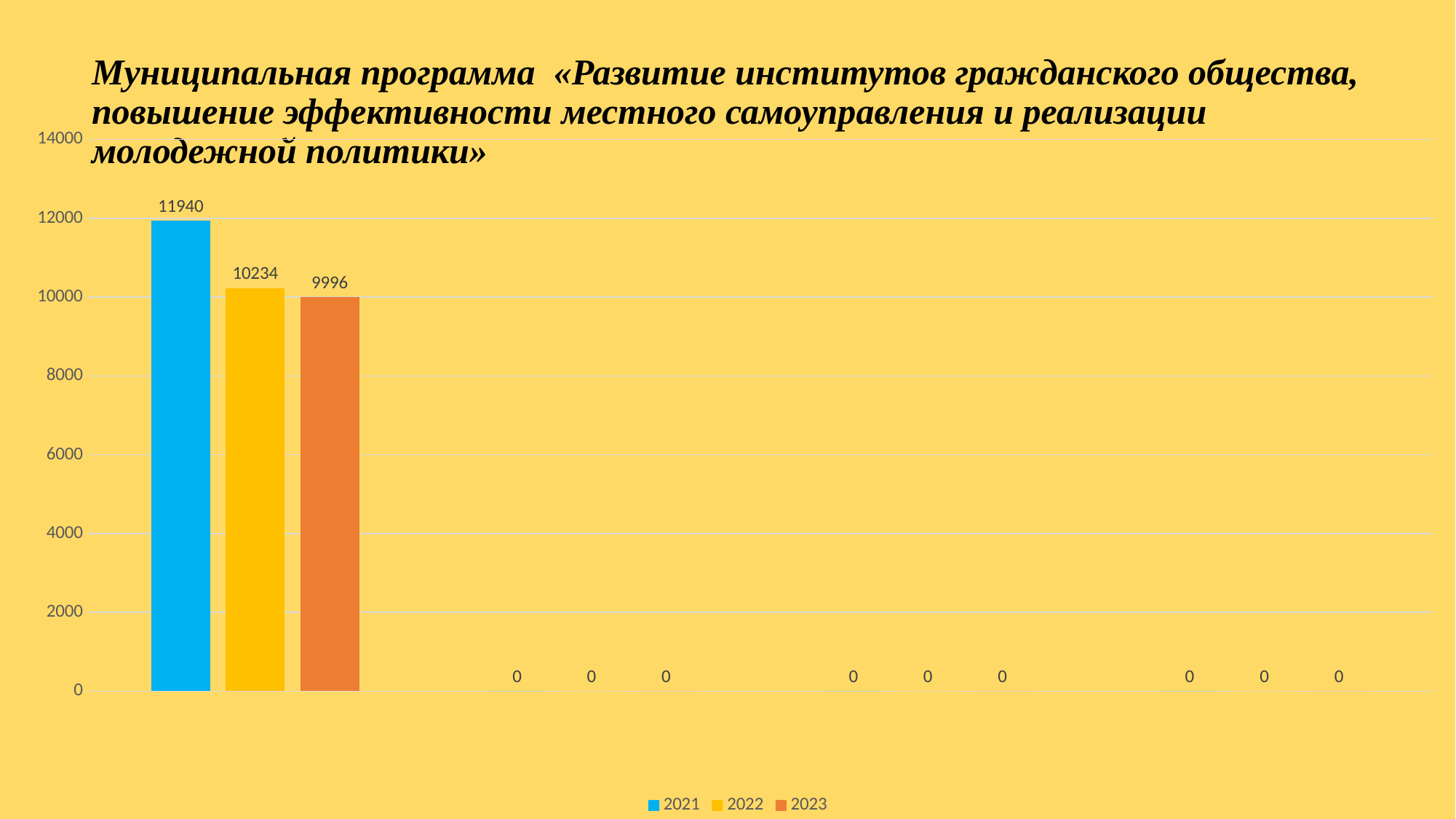
Is the 2021 value in the first group of bars greater or less than 10000? greater Which series has the highest value in the first group of bars? 2021 How many series does the legend list? 3 Which series has the lowest value in the first group of bars? 2023 What is the difference between the 2022 and 2023 values in the first group of bars? 238 What is the value of the 2022 bar in the first group of bars? 10234 What is the value of the 2021 bar in the first group of bars? 11940 What kind of chart is shown on the slide? bar chart Which series is shown in blue in the legend? 2021 What is the difference between the 2021 and 2022 values in the first group of bars? 1706 Do the values in the first group of bars rise or fall from 2021 to 2023? fall What is the value of the 2023 bar in the first group of bars? 9996